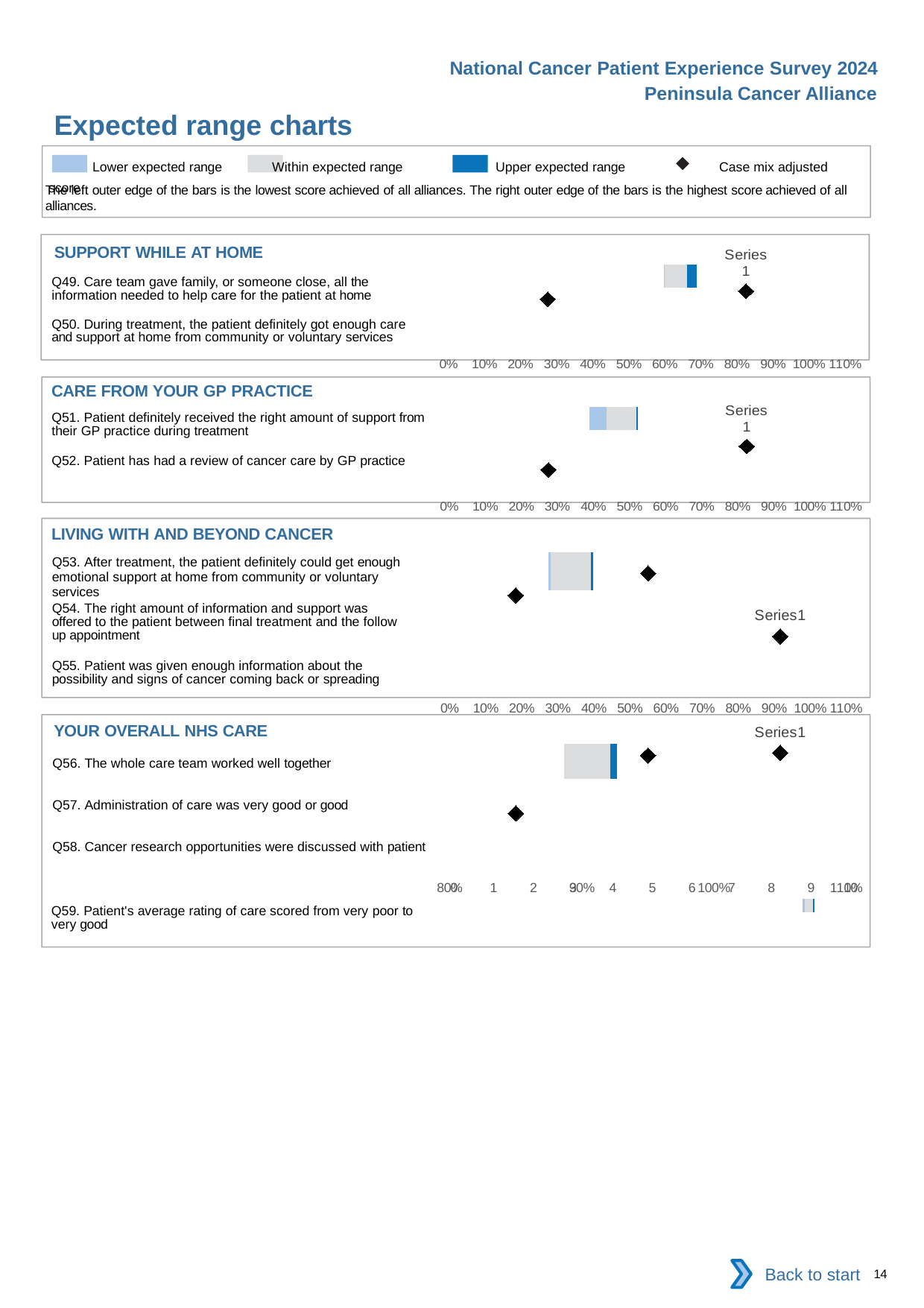
In the SUPPORT WHILE AT HOME chart, is the expected range bar positioned greater or less than 50%? greater What kind of chart is used in the SUPPORT WHILE AT HOME section? bar chart How many questions are listed in the LIVING WITH AND BEYOND CANCER chart? 3 How many entries does the legend at the top of the slide list? 4 How many questions are listed in the SUPPORT WHILE AT HOME chart? 2 In the YOUR OVERALL NHS CARE chart, is the expected range bar for Q59 (average rating of care) greater or less than 5 on the 0-10 scale? greater Which legend entry is shown in dark blue? Upper expected range How many questions are listed in the CARE FROM YOUR GP PRACTICE chart? 2 According to the legend, what does the black diamond marker represent? Case mix adjusted score In the CARE FROM YOUR GP PRACTICE chart, is the expected range bar positioned greater or less than 30%? greater